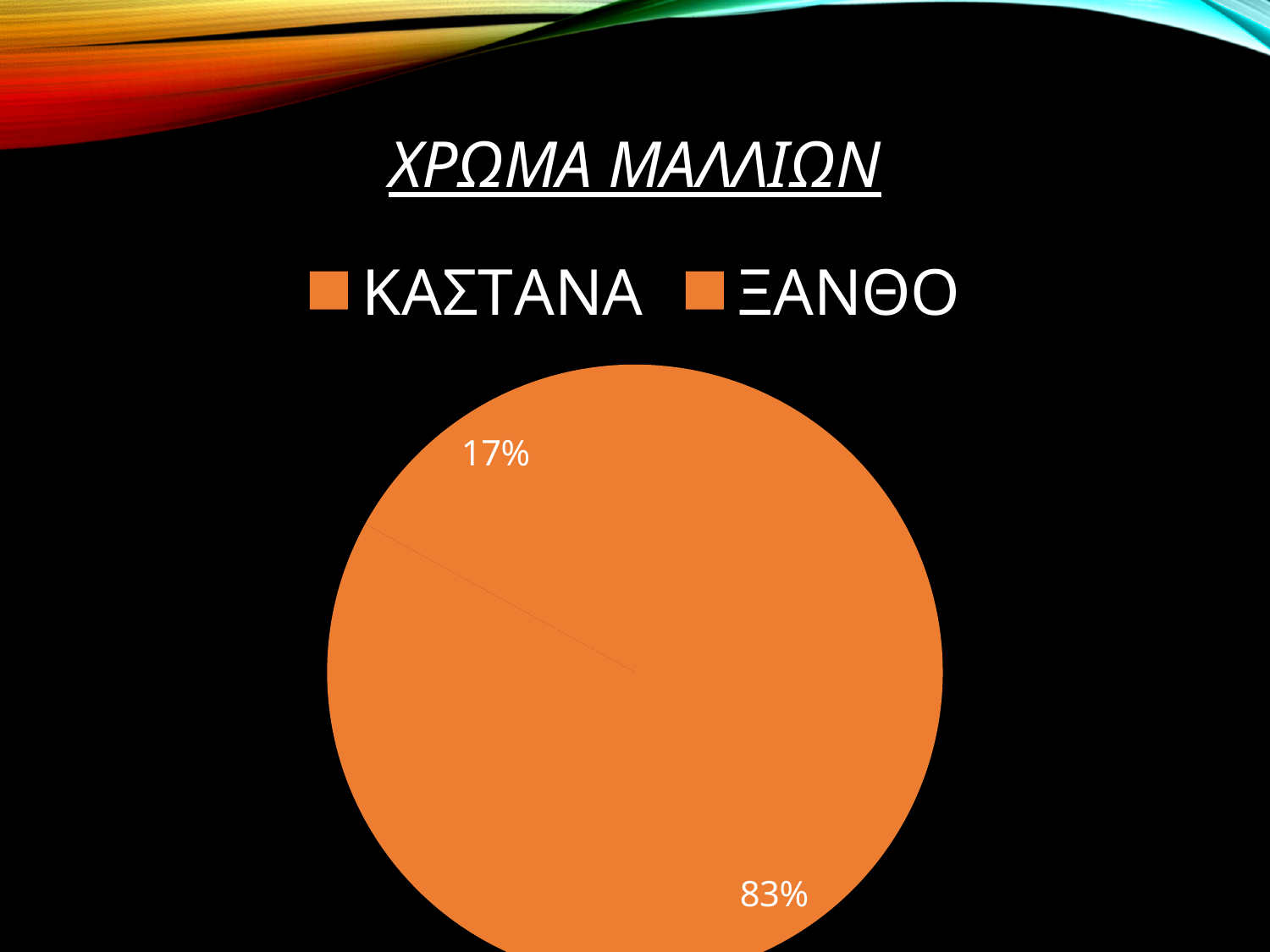
Is the largest slice of the pie chart greater or less than 50%? greater What kind of chart is shown on the slide? pie chart What are the two legend entries of the pie chart? ΚΑΣΤΑΝΑ and ΞΑΝΘΟ Is the smallest slice of the pie chart greater or less than 25%? less How many data labels are printed on the pie chart? 2 What is the difference between the two shares shown on the pie chart? 66% What is the title of the chart? ΧΡΩΜΑ ΜΑΛΛΙΩΝ What is the smallest share shown on the pie chart? 17% How many categories does the legend of the pie chart list? 2 What is the largest share shown on the pie chart? 83%